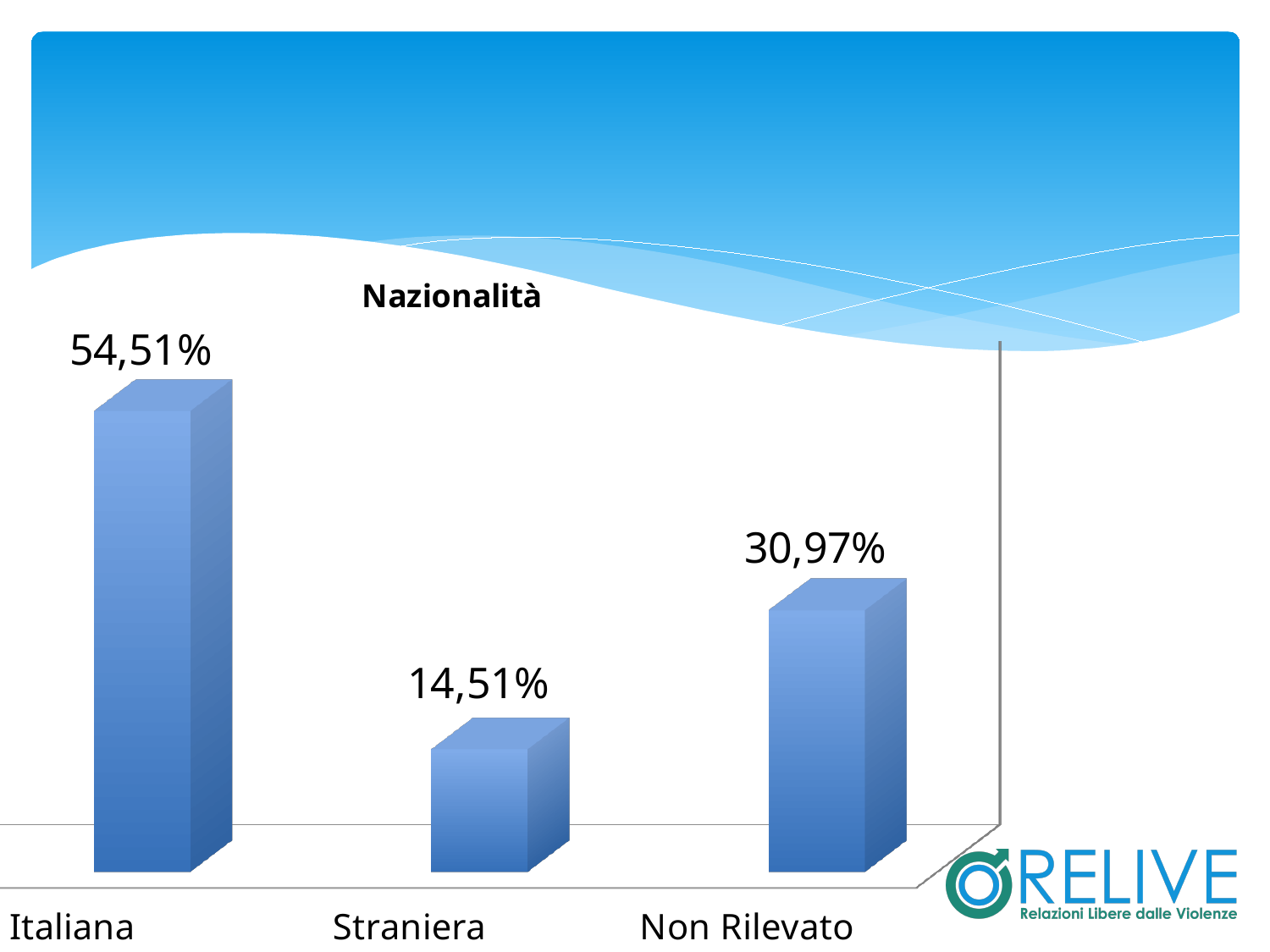
Which category has the lowest value? Straniera What is the value for Italiana? 54,51% Which category has the highest value? Italiana What is the difference between the values for Non Rilevato and Straniera? 16,46% What is the value for Straniera? 14,51% Which is larger, the value for Straniera or the value for Non Rilevato? Non Rilevato What is the value for Non Rilevato? 30,97% What is the difference between the values for Italiana and Non Rilevato? 23,54% What is the title of the chart? Nazionalità What is the total of the three values shown in the chart? 99,99% What kind of chart is shown on the slide? Bar chart How many categories are shown in the chart? 3